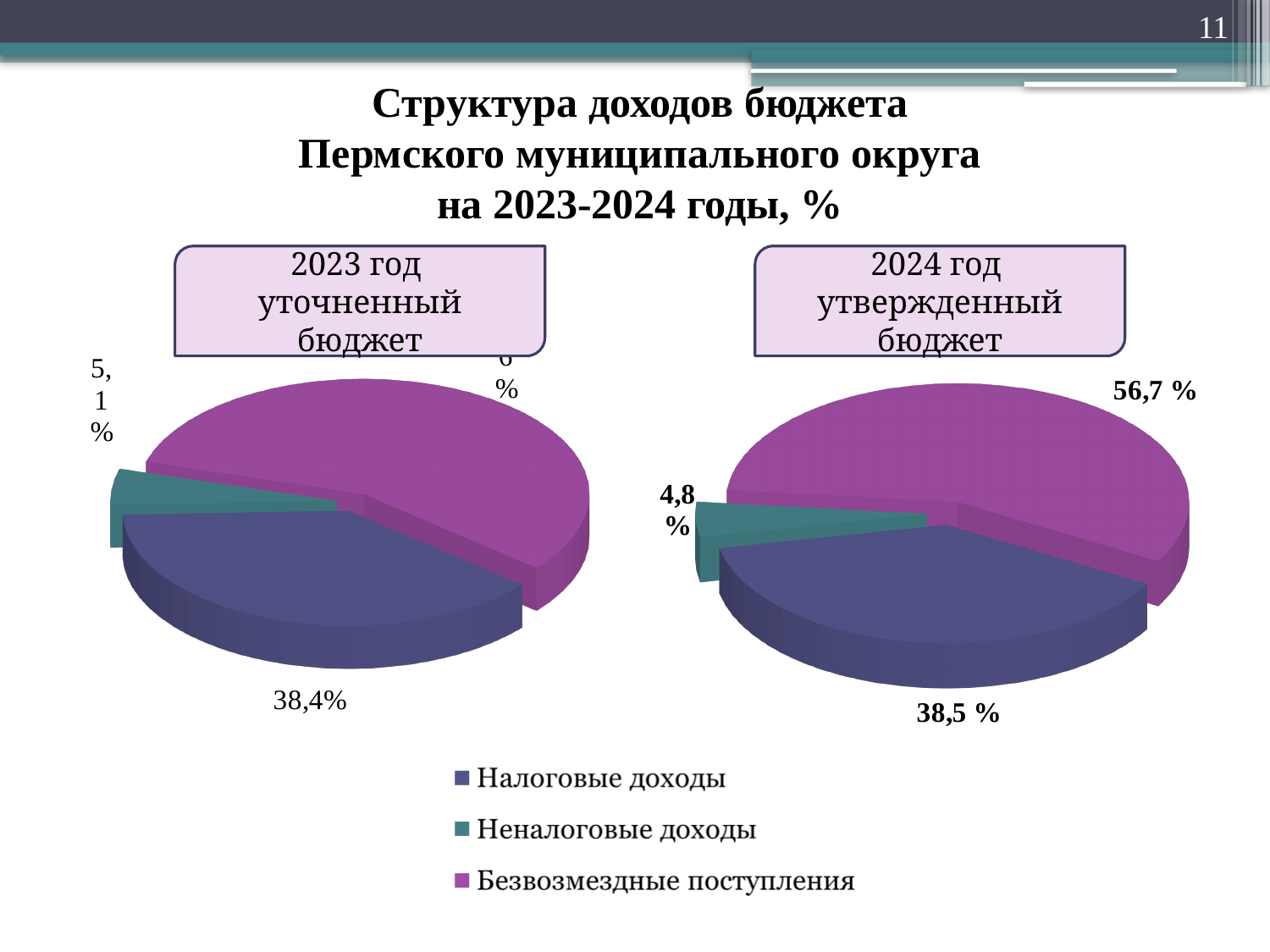
In the 2024 год утвержденный бюджет chart, what is the share of Неналоговые доходы? 4,8 % In the 2024 год утвержденный бюджет chart, what is the share of Налоговые доходы? 38,5 % What kind of chart is used on this slide? Pie chart In the 2023 год уточненный бюджет chart, what is the share of Налоговые доходы? 38,4% In the 2023 год уточненный бюджет chart, what is the share of Неналоговые доходы? 5,1% In the 2023 год уточненный бюджет chart, which category has the smallest share? Неналоговые доходы In the 2024 год утвержденный бюджет chart, what is the share of Безвозмездные поступления? 56,7 % What is the title of the slide's charts? Структура доходов бюджета Пермского муниципального округа на 2023-2024 годы, % How many categories does the legend list? 3 In the 2024 год утвержденный бюджет chart, which category has the largest share? Безвозмездные поступления In the 2024 год утвержденный бюджет chart, what is the difference between the shares of Безвозмездные поступления and Налоговые доходы? 18,2 % In the 2024 год утвержденный бюджет chart, which category has the smallest share? Неналоговые доходы